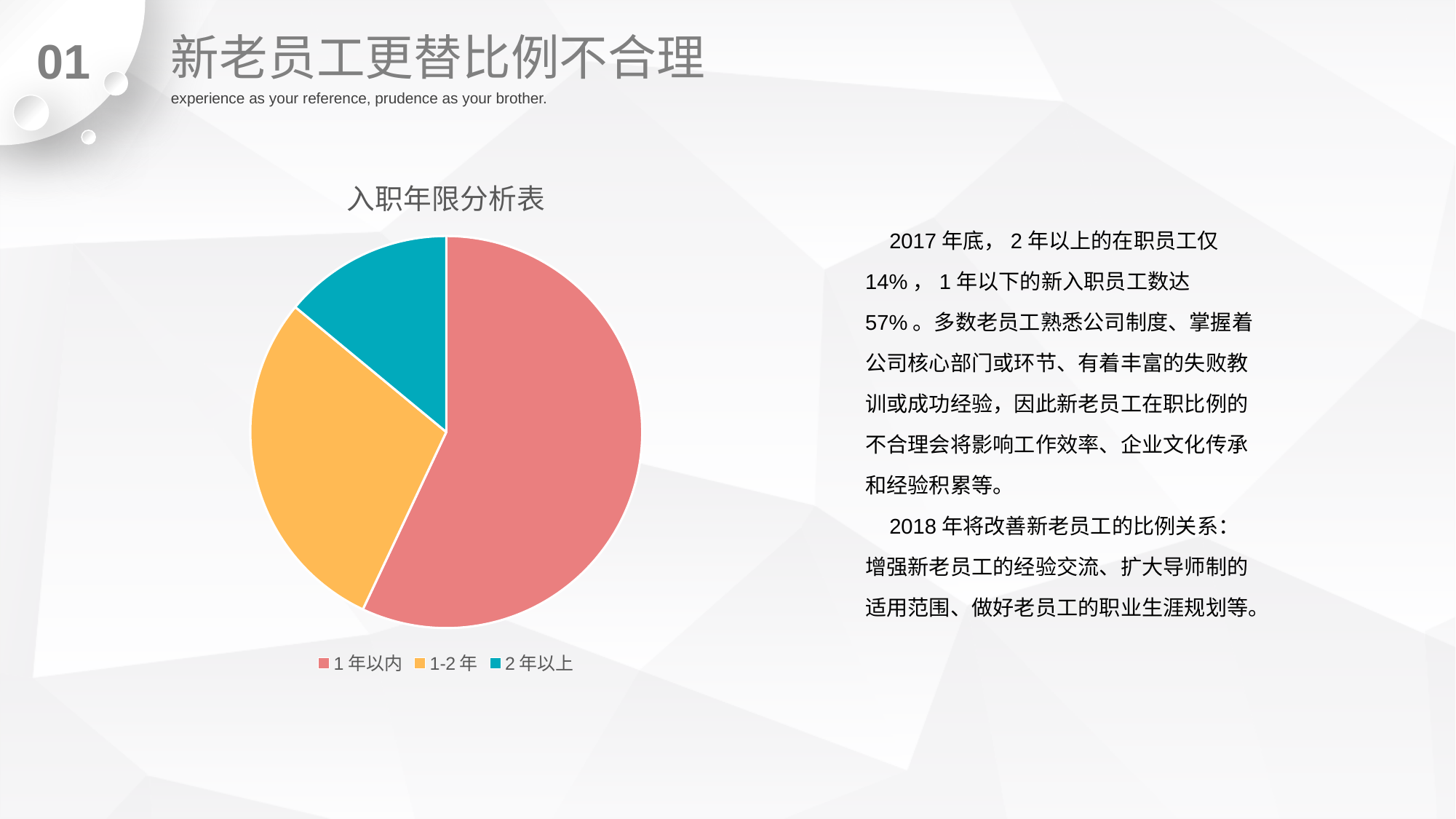
Which colour represents the 2 年以上 category in the pie chart? teal What kind of chart is shown on the slide? pie chart Which slice is larger, 1 年以内 or 1-2 年? 1 年以内 How many slices does the pie chart have? 3 Which slice is larger, 1-2 年 or 2 年以上? 1-2 年 Does the 1 年以内 slice take up more or less than half of the pie? more Which category has the smallest slice of the pie? 2 年以上 Which category has the largest slice of the pie? 1 年以内 How many entries does the chart legend list? 3 What is the title of the chart? 入职年限分析表